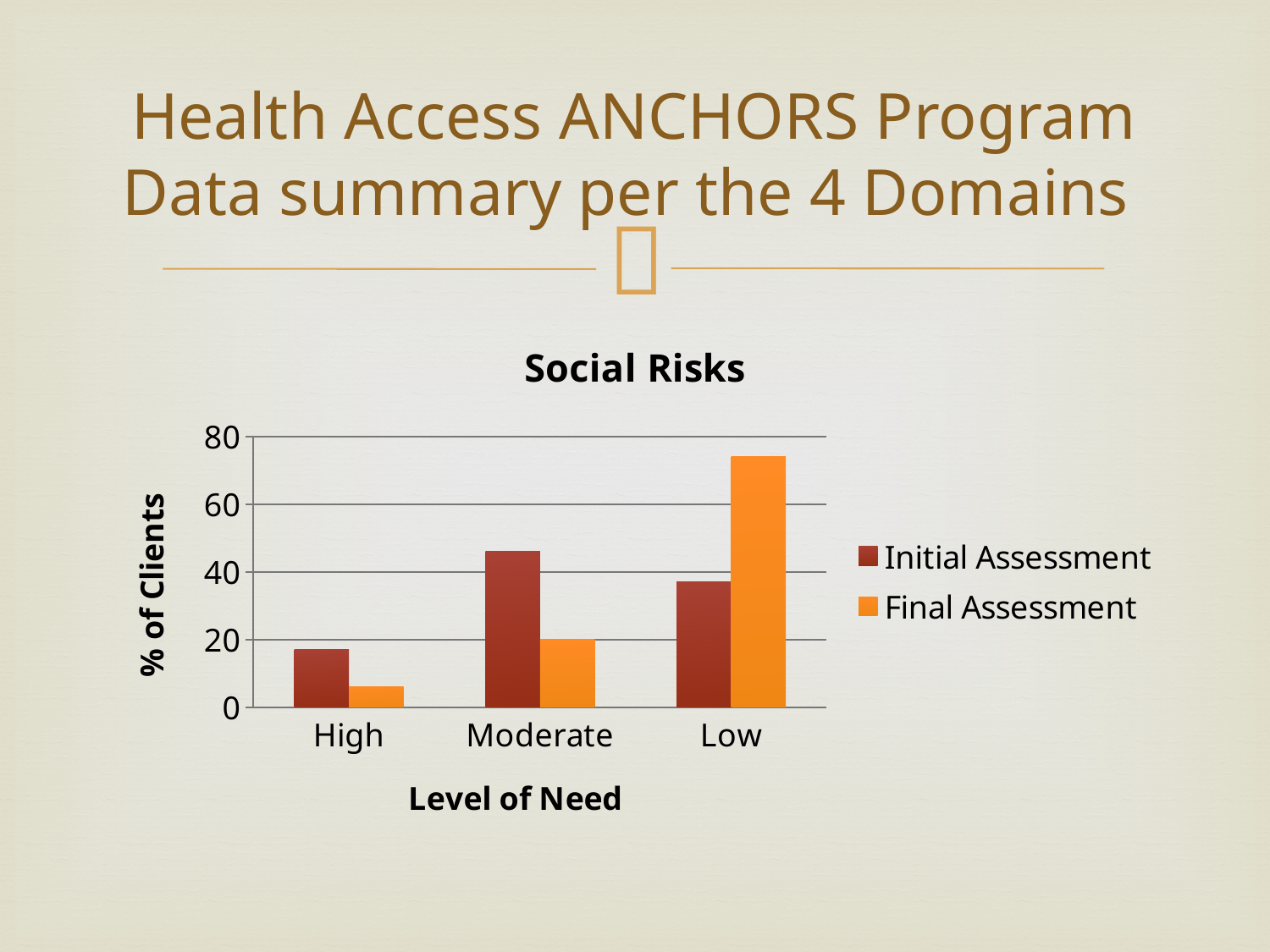
Is the Final Assessment value for Low greater or less than 60? greater Which level of need has the highest Initial Assessment value? Moderate How many series does the legend list? 2 For the Moderate level of need, which is larger: Initial Assessment or Final Assessment? Initial Assessment What is the title of the chart? Social Risks Which level of need has the lowest Initial Assessment value? High Which level of need has the highest Final Assessment value? Low How many levels of need are shown on the x axis? 3 Which level of need has the lowest Final Assessment value? High What kind of chart is shown on the slide? bar chart For the Low level of need, which is larger: Initial Assessment or Final Assessment? Final Assessment Is the Initial Assessment value for High greater or less than 20? less